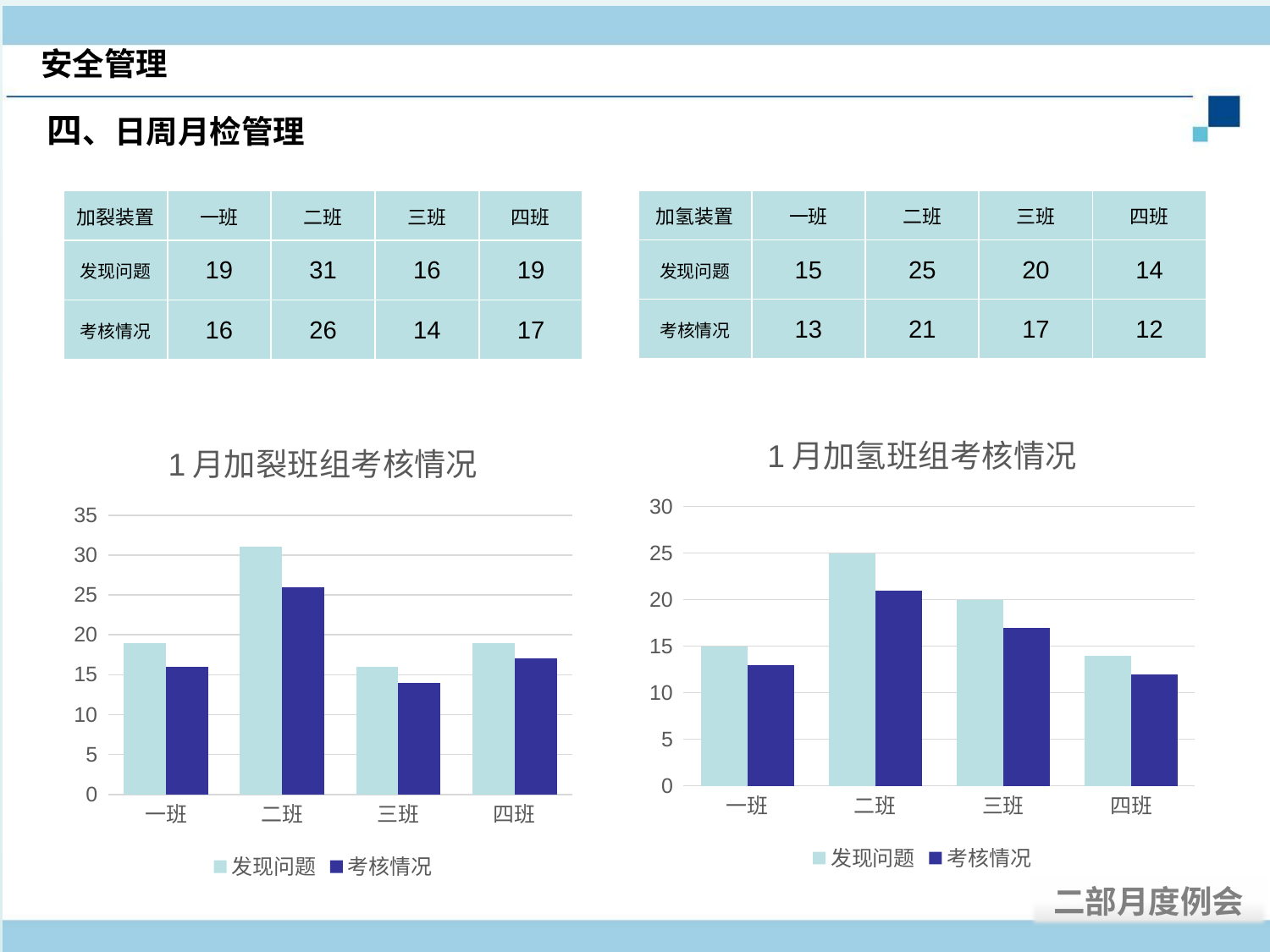
In the chart titled 1月加氢班组考核情况, what is the value of 考核情况 for 三班? 17 How many categories are shown on the x axis of the chart titled 1月加氢班组考核情况? 4 In the chart titled 1月加裂班组考核情况, what is the value of 发现问题 for 二班? 31 What is the title of the chart on the left side of the slide? 1月加裂班组考核情况 In the chart titled 1月加裂班组考核情况, is the 考核情况 value for 二班 greater or less than 20? greater In the chart titled 1月加裂班组考核情况, which category has the highest 发现问题 value? 二班 In the chart titled 1月加氢班组考核情况, which is larger, the 发现问题 value for 三班 or for 一班? 三班 In the chart titled 1月加氢班组考核情况, what is the difference between the 发现问题 values for 二班 and 四班? 11 How many series does the legend of the chart titled 1月加裂班组考核情况 list? 2 In the chart titled 1月加氢班组考核情况, which category has the lowest 考核情况 value? 四班 In the chart titled 1月加裂班组考核情况, what is the difference between 发现问题 and 考核情况 for 二班? 5 What kind of chart is the chart titled 1月加氢班组考核情况? bar chart